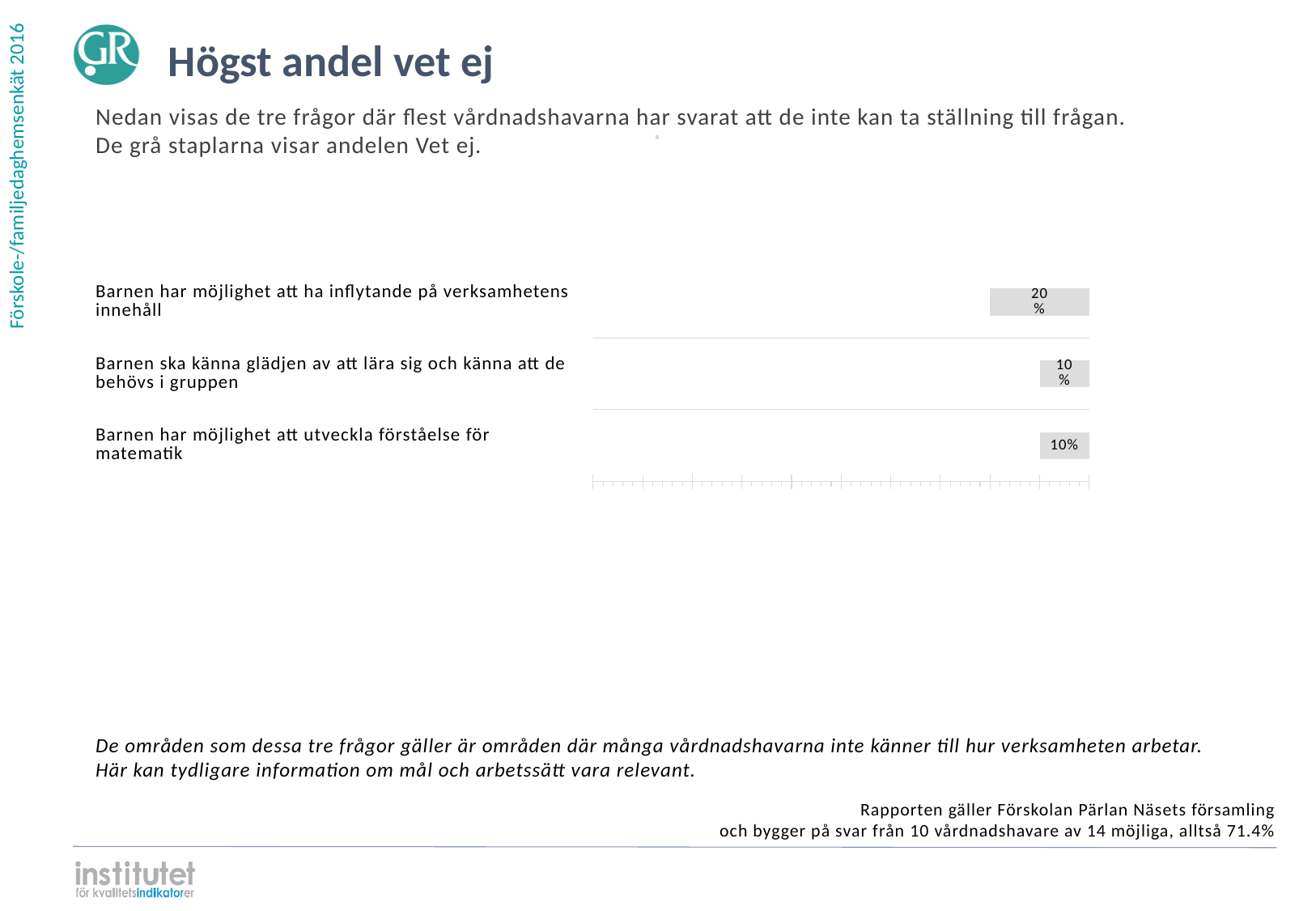
What is the Vet ej share for "Barnen ska känna glädjen av att lära sig och känna att de behövs i gruppen"? 10% Which is larger: the Vet ej share for "Barnen har möjlighet att ha inflytande på verksamhetens innehåll" or for "Barnen ska känna glädjen av att lära sig och känna att de behövs i gruppen"? Barnen har möjlighet att ha inflytande på verksamhetens innehåll What is the Vet ej share for "Barnen har möjlighet att utveckla förståelse för matematik"? 10% Do the Vet ej values rise or fall going from the top category to the bottom category? Fall What is the difference between the Vet ej share for "Barnen har möjlighet att ha inflytande på verksamhetens innehåll" and for "Barnen har möjlighet att utveckla förståelse för matematik"? 10% What kind of chart is shown on the slide? Bar chart How many questions (categories) are shown in the chart? 3 Which question has the highest Vet ej share? Barnen har möjlighet att ha inflytande på verksamhetens innehåll What is the Vet ej share for "Barnen har möjlighet att ha inflytande på verksamhetens innehåll"? 20% What colour are the bars in the chart? Grey What is the title of the slide containing the chart? Högst andel vet ej